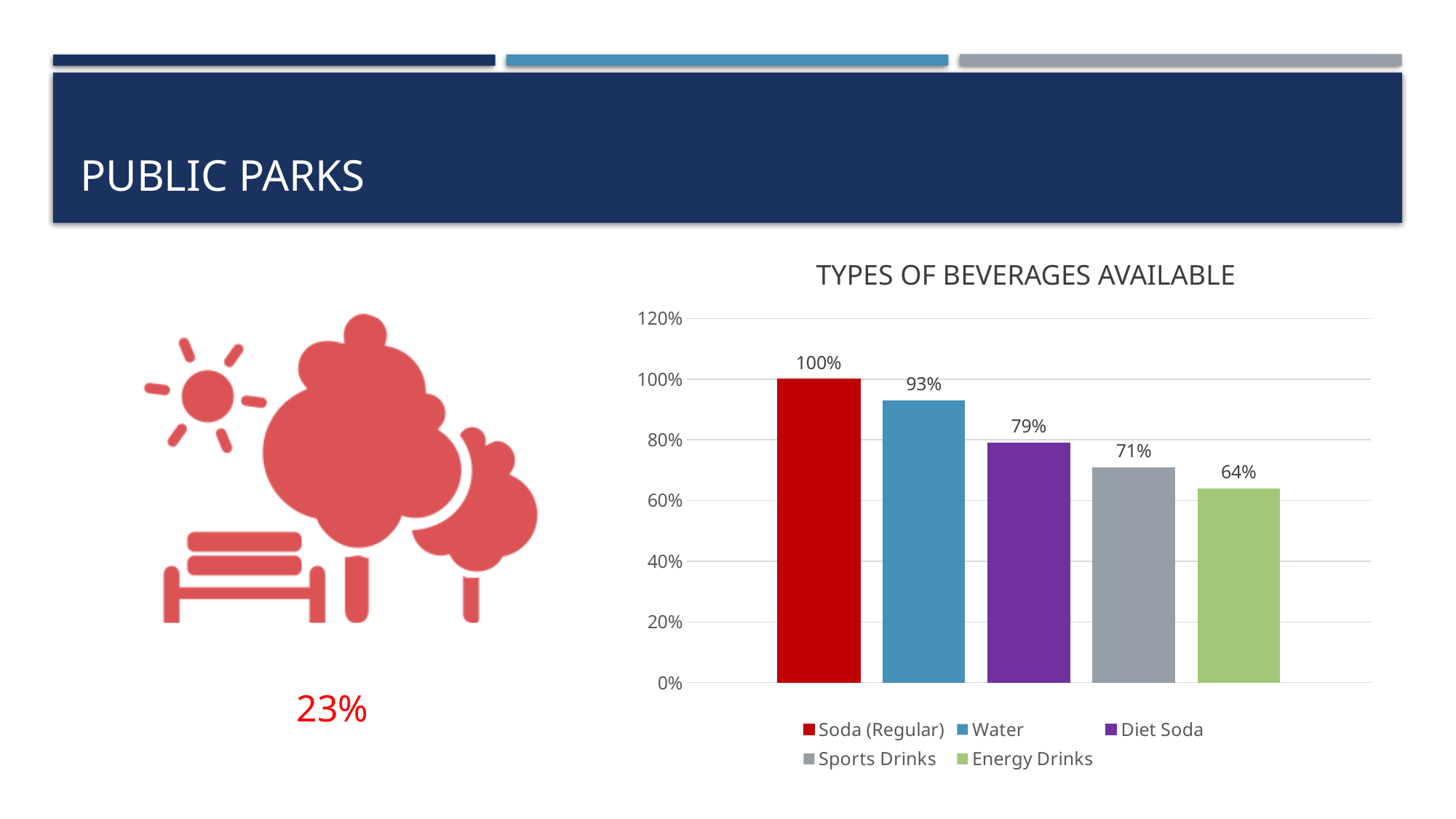
Which beverage type has the highest value in the chart? Soda (Regular) Is the value for Sports Drinks greater or less than 80%? less Which is larger, the value for Water or the value for Diet Soda? Water What is the value for Diet Soda in the Types of Beverages Available chart? 79% How many entries does the chart legend list? 5 What is the value for Water in the Types of Beverages Available chart? 93% What kind of chart is shown on the slide? bar chart What is the difference between the values for Soda (Regular) and Sports Drinks? 29% Which beverage type has the lowest value in the chart? Energy Drinks What is the value for Energy Drinks in the Types of Beverages Available chart? 64% Do the values rise or fall from left to right across the chart? fall How many beverage types are shown in the chart? 5